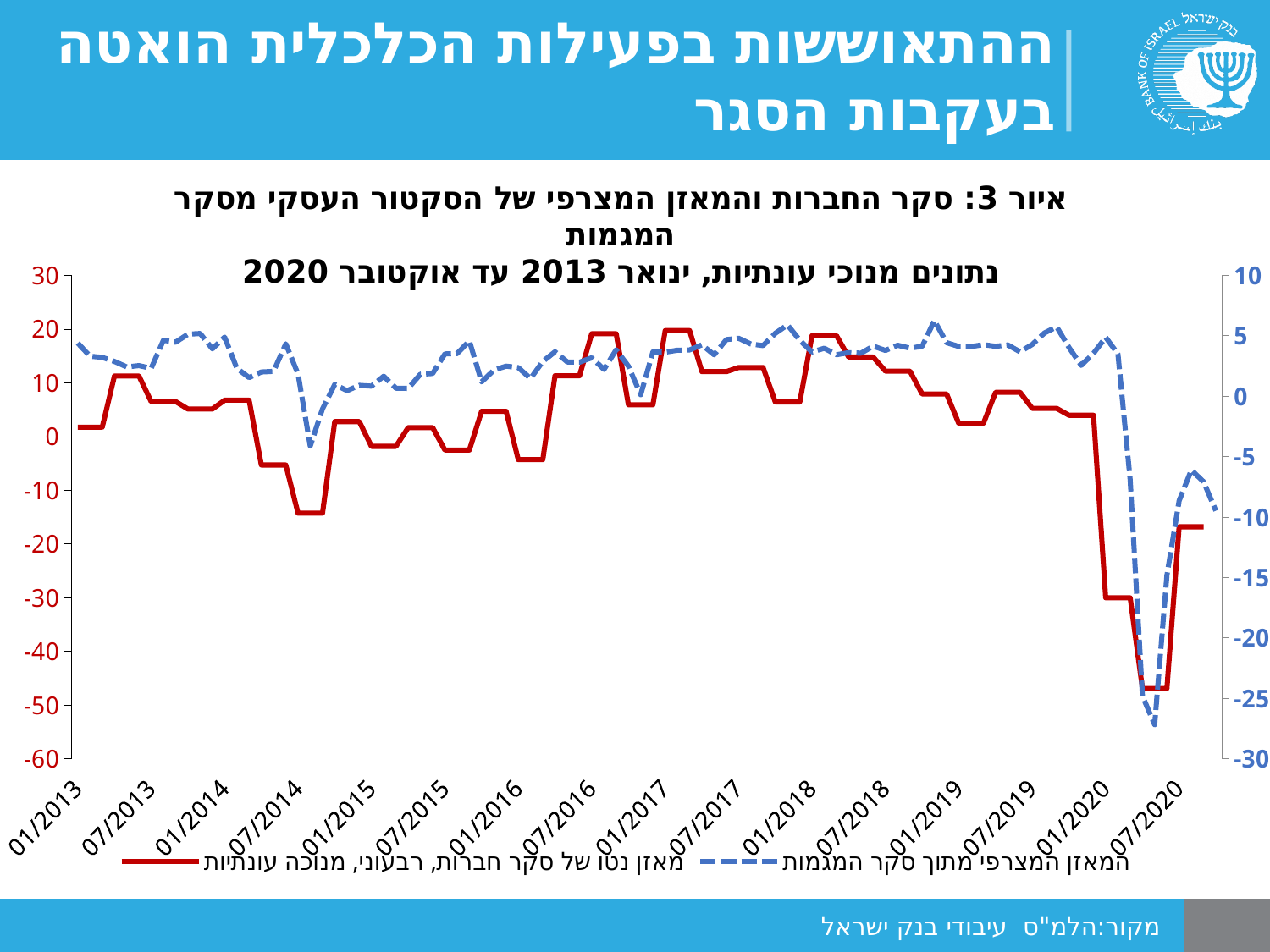
What kind of chart is shown on the slide? line chart What is the lowest value shown on the right vertical axis? -30 What is the highest value shown on the left vertical axis? 30 Does the solid red line rise or fall between 01/2020 and its lowest point in 2020? fall Which series is drawn as a blue dashed line? המאזן המצרפי מתוך סקר המגמות How many series does the legend list? 2 Is the value of the solid red line at 07/2020 greater or less than -10 on the left axis? less Which series is drawn as a solid red line? מאזן נטו של סקר חברות, רבעוני, מנוכה עונתיות How many date labels are shown along the x axis? 16 Is the value of the solid red line at 01/2013 greater or less than 10 on the left axis? less Is the lowest point of the blue dashed line greater or less than -20 on the right axis? less